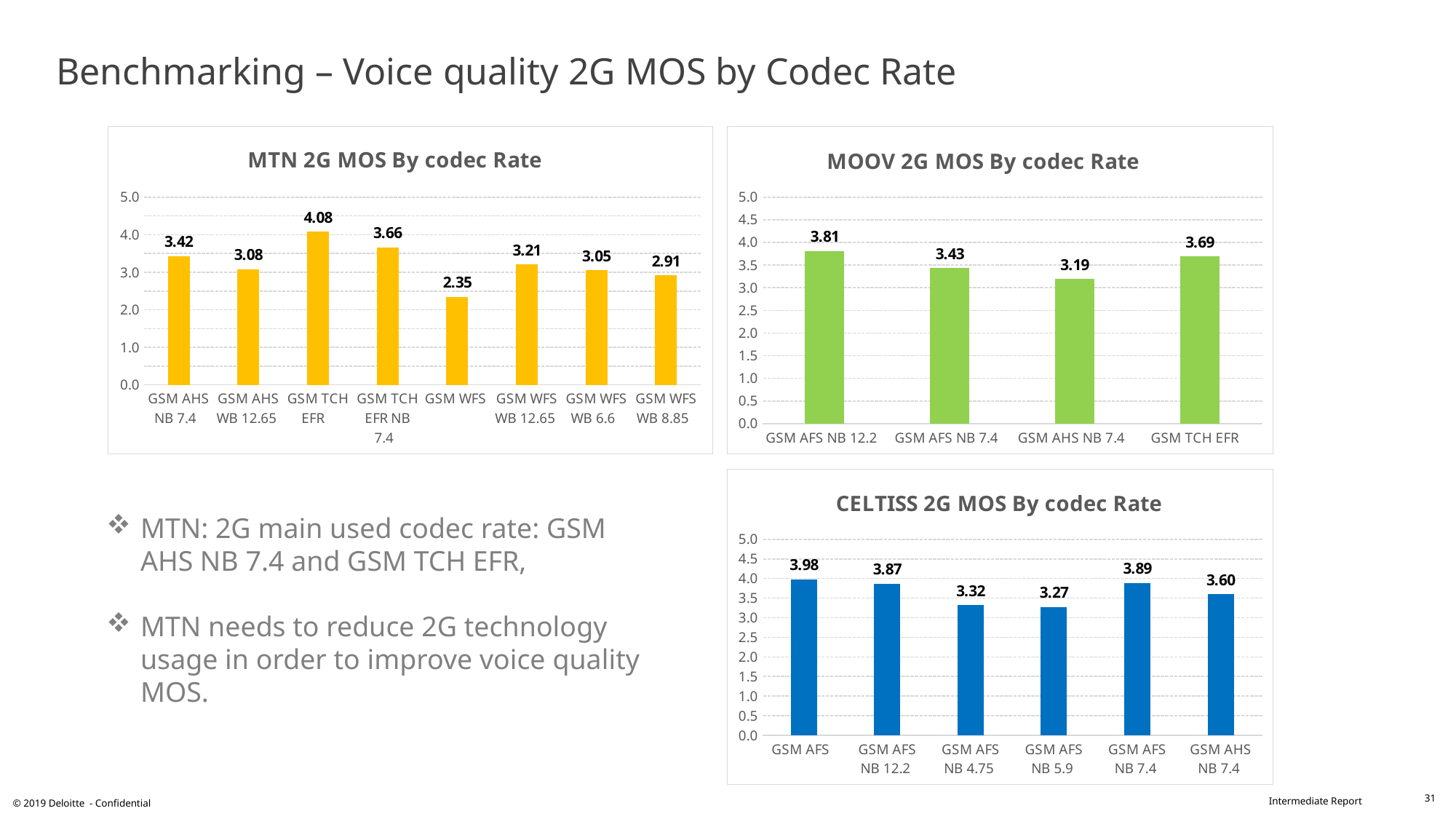
What kind of chart is the CELTISS 2G MOS By codec Rate chart? Bar chart In the MTN 2G MOS By codec Rate chart, how many codec rate categories are shown? 8 In the CELTISS 2G MOS By codec Rate chart, which codec rate has the lowest MOS? GSM AFS NB 5.9 In the MOOV 2G MOS By codec Rate chart, what is the value for GSM AHS NB 7.4? 3.19 In the MTN 2G MOS By codec Rate chart, what is the value for GSM TCH EFR? 4.08 In the MOOV 2G MOS By codec Rate chart, how many codec rate categories are shown? 4 In the MOOV 2G MOS By codec Rate chart, which codec rate has the highest MOS? GSM AFS NB 12.2 In the MTN 2G MOS By codec Rate chart, what is the difference between GSM TCH EFR and GSM AHS NB 7.4? 0.66 In the CELTISS 2G MOS By codec Rate chart, which is larger: GSM AFS or GSM AHS NB 7.4? GSM AFS In the CELTISS 2G MOS By codec Rate chart, what is the value for GSM AFS NB 7.4? 3.89 In the MTN 2G MOS By codec Rate chart, which codec rate has the lowest MOS? GSM WFS What colour are the bars in the MOOV 2G MOS By codec Rate chart? Green